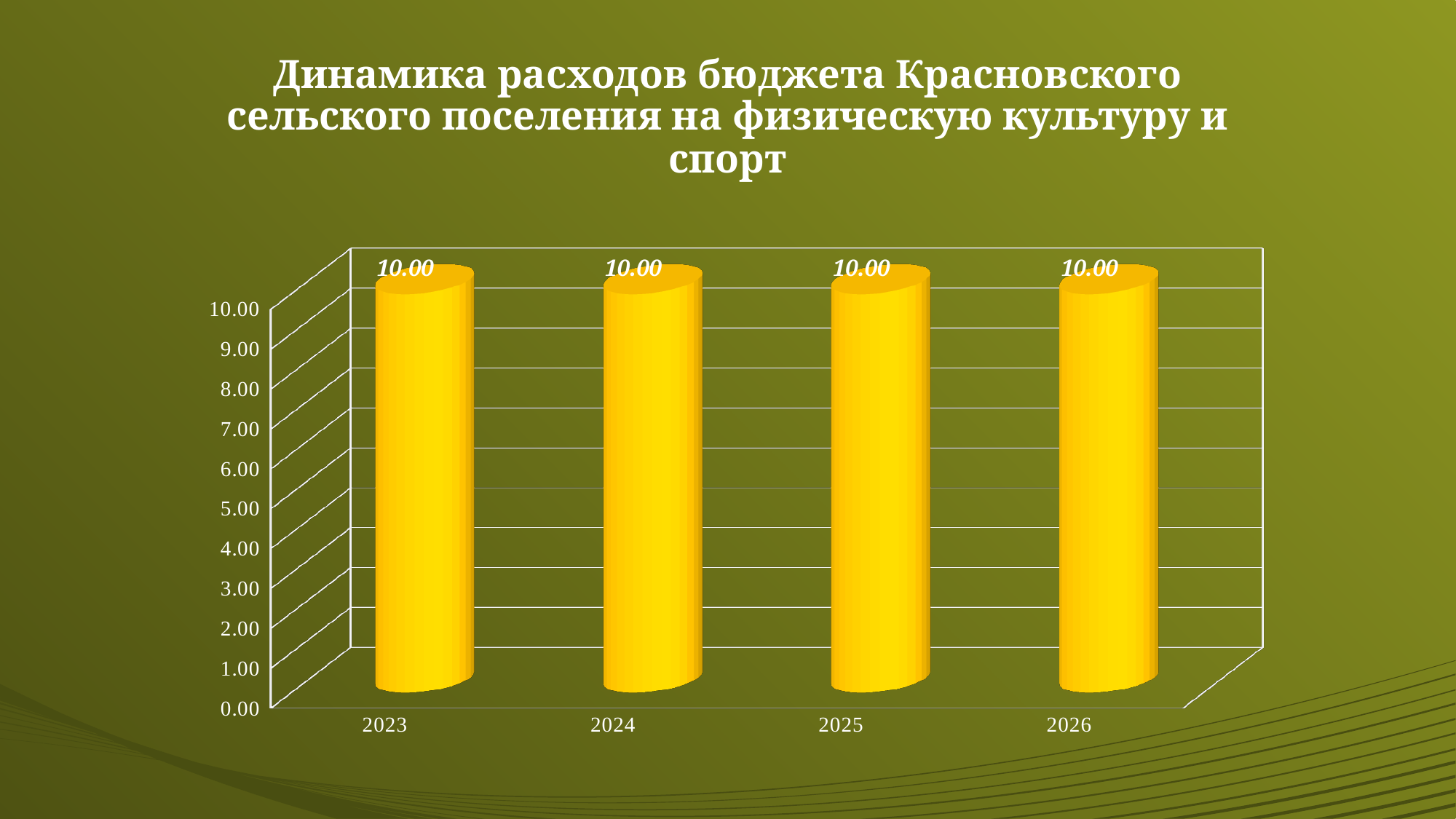
Do the values rise, fall or stay the same from 2023 to 2026? Stay the same Is the value for 2024 larger than, smaller than or equal to the value for 2025? Equal What is the title of the chart? Динамика расходов бюджета Красновского сельского поселения на физическую культуру и спорт What is the value for 2024? 10.00 What is the value for 2023? 10.00 What is the value for 2025? 10.00 What kind of chart is shown on the slide? Bar chart How many categories are shown on the x axis? 4 What is the difference between the values for 2026 and 2023? 0.00 What colour are the bars in the chart? Yellow Is the value for 2025 greater or less than 5.00? greater What is the value for 2026? 10.00